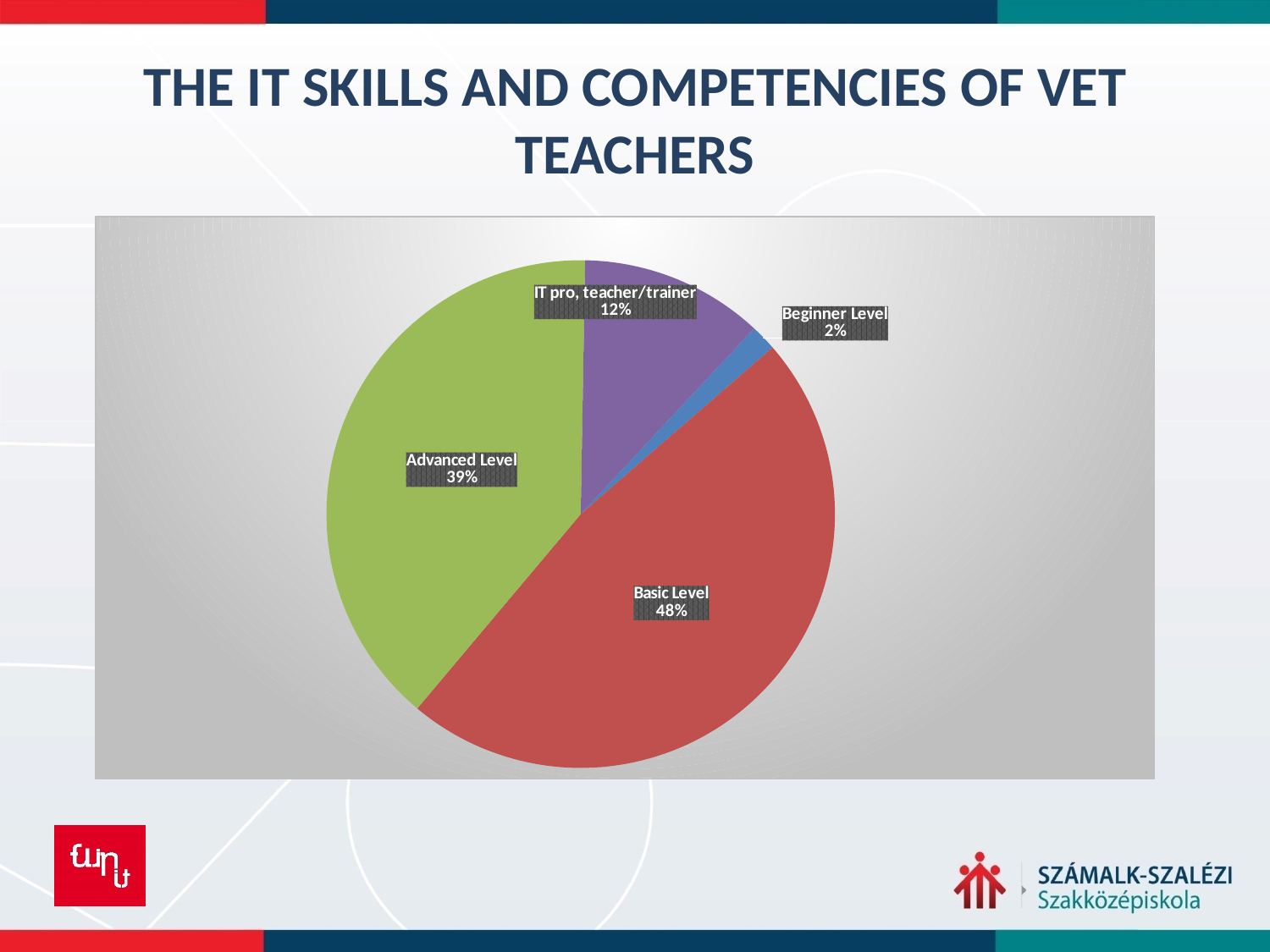
Which category has the smallest slice of the pie? Beginner Level Which category has the largest slice of the pie? Basic Level What share of the pie is Basic Level? 48% What share of the pie is Beginner Level? 2% What share of the pie is IT pro, teacher/trainer? 12% Which is larger, the share for Advanced Level or the share for IT pro, teacher/trainer? Advanced Level What colour is the Advanced Level slice? Green What is the title of the slide containing the chart? THE IT SKILLS AND COMPETENCIES OF VET TEACHERS What is the difference between the Basic Level and Advanced Level shares? 9% What kind of chart is shown on the slide? Pie chart How many categories are shown in the pie chart? 4